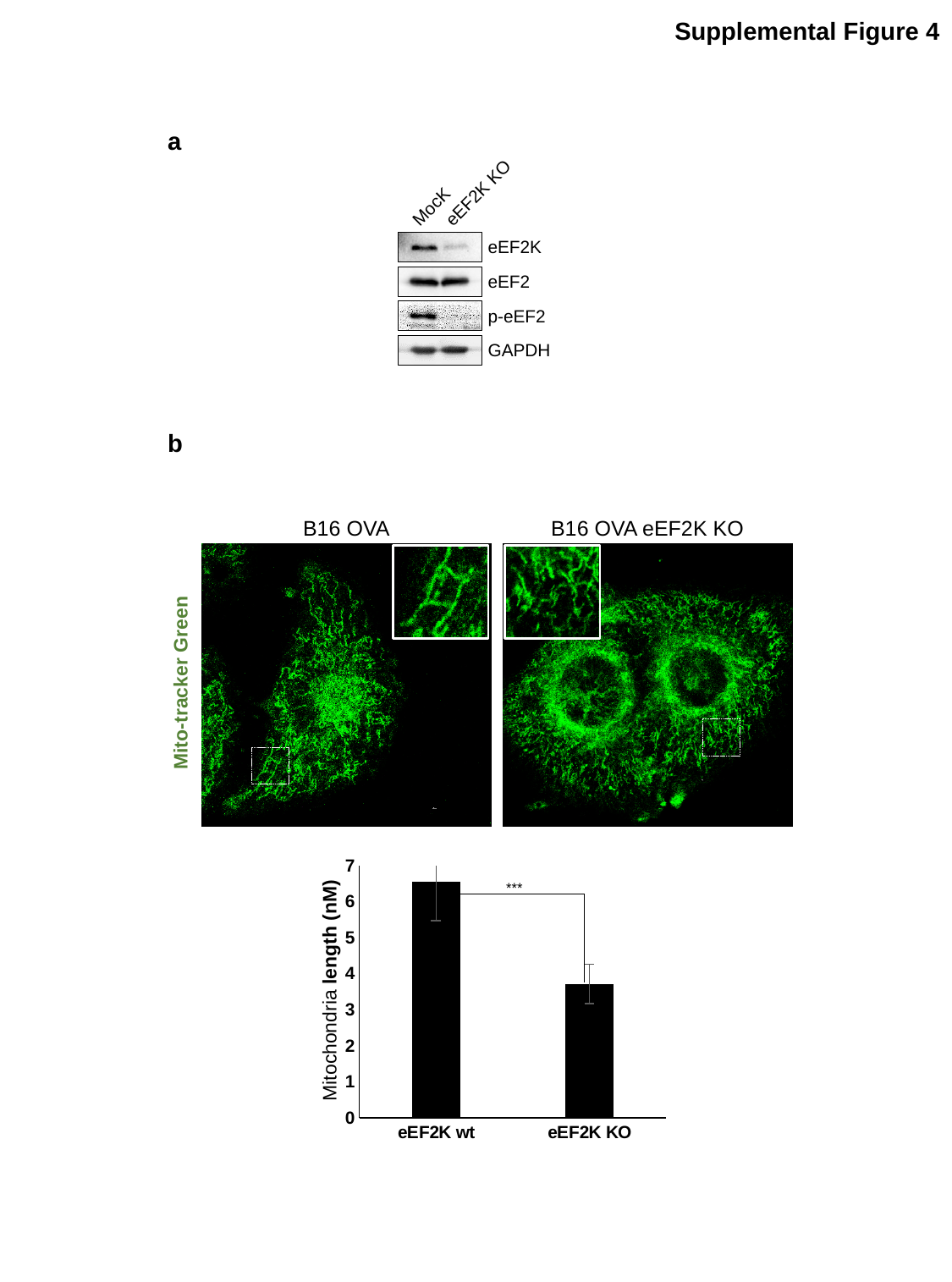
Which category has the highest mitochondria length in the bar chart? eEF2K wt Which category has the lowest mitochondria length in the bar chart? eEF2K KO Do the bar values rise or fall from eEF2K wt to eEF2K KO? fall In the bar chart, is the value for eEF2K KO greater or less than 3? greater How many categories are plotted on the x axis of the bar chart? 2 What is the maximum value shown on the y axis of the bar chart? 7 What kind of chart is shown at the bottom of the slide? bar chart In the bar chart, is the mitochondria length larger for eEF2K wt or eEF2K KO? eEF2K wt What is the label of the y axis of the bar chart? Mitochondria length (nM) In the bar chart, is the value for eEF2K KO greater or less than 4? less In the bar chart, is the value for eEF2K wt greater or less than 6? greater